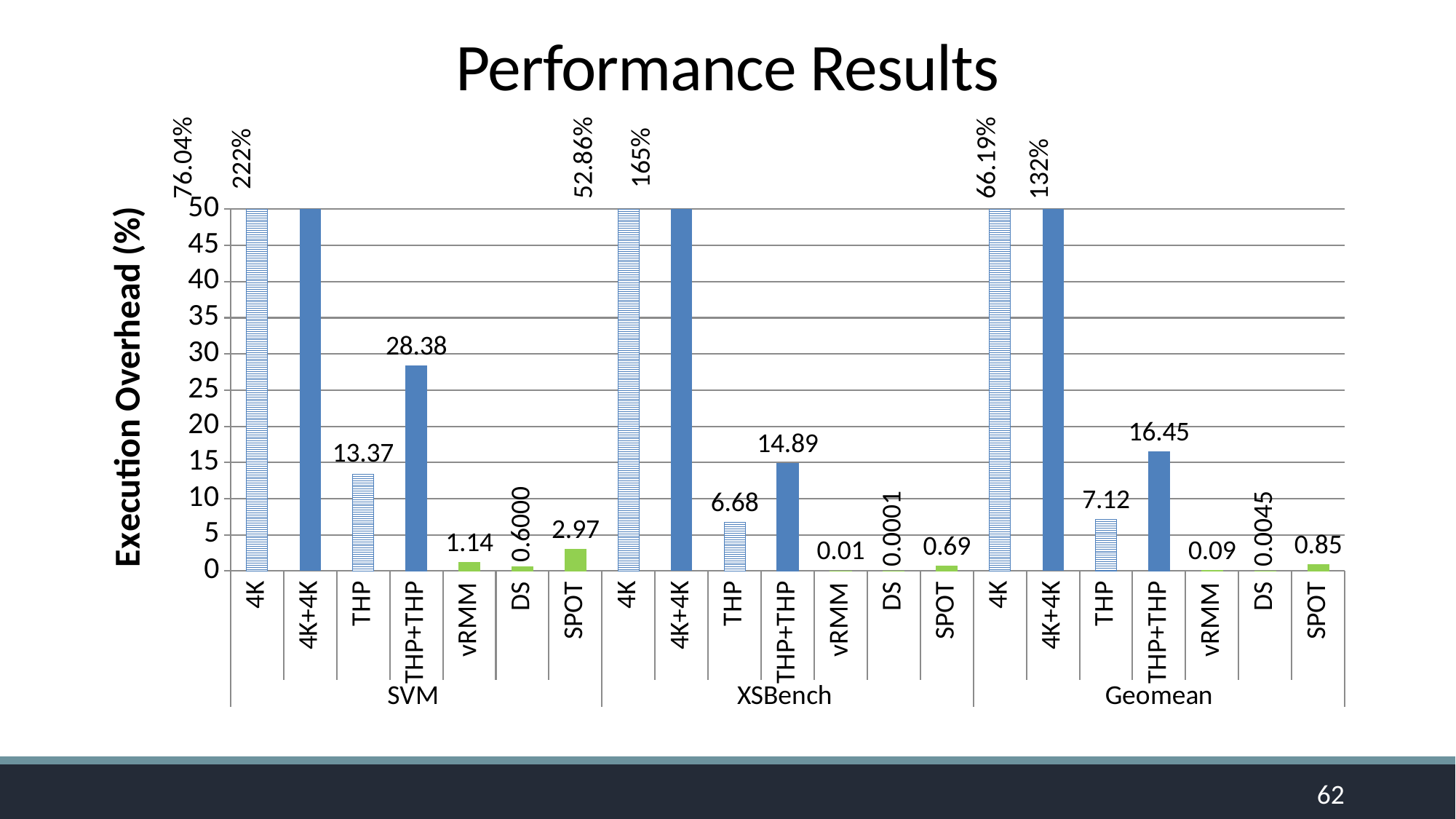
What kind of chart is shown on the slide? bar chart In the SVM group, which has the larger execution overhead, SPOT or vRMM? SPOT What is the title of the y axis? Execution Overhead (%) What is the execution overhead for vRMM in the Geomean group? 0.09 What is the execution overhead for THP in the XSBench group? 6.68 How many benchmark groups are shown along the x axis? 3 What is the execution overhead for THP+THP in the SVM group? 28.38 What is the execution overhead for THP+THP in the Geomean group? 16.45 In the Geomean group, what is the difference between the execution overhead for THP+THP and for THP? 9.33 In the SVM group, how much higher is the execution overhead for THP+THP than for THP? 15.01 What is the execution overhead for DS in the Geomean group? 0.0045 What is the execution overhead for SPOT in the XSBench group? 0.69